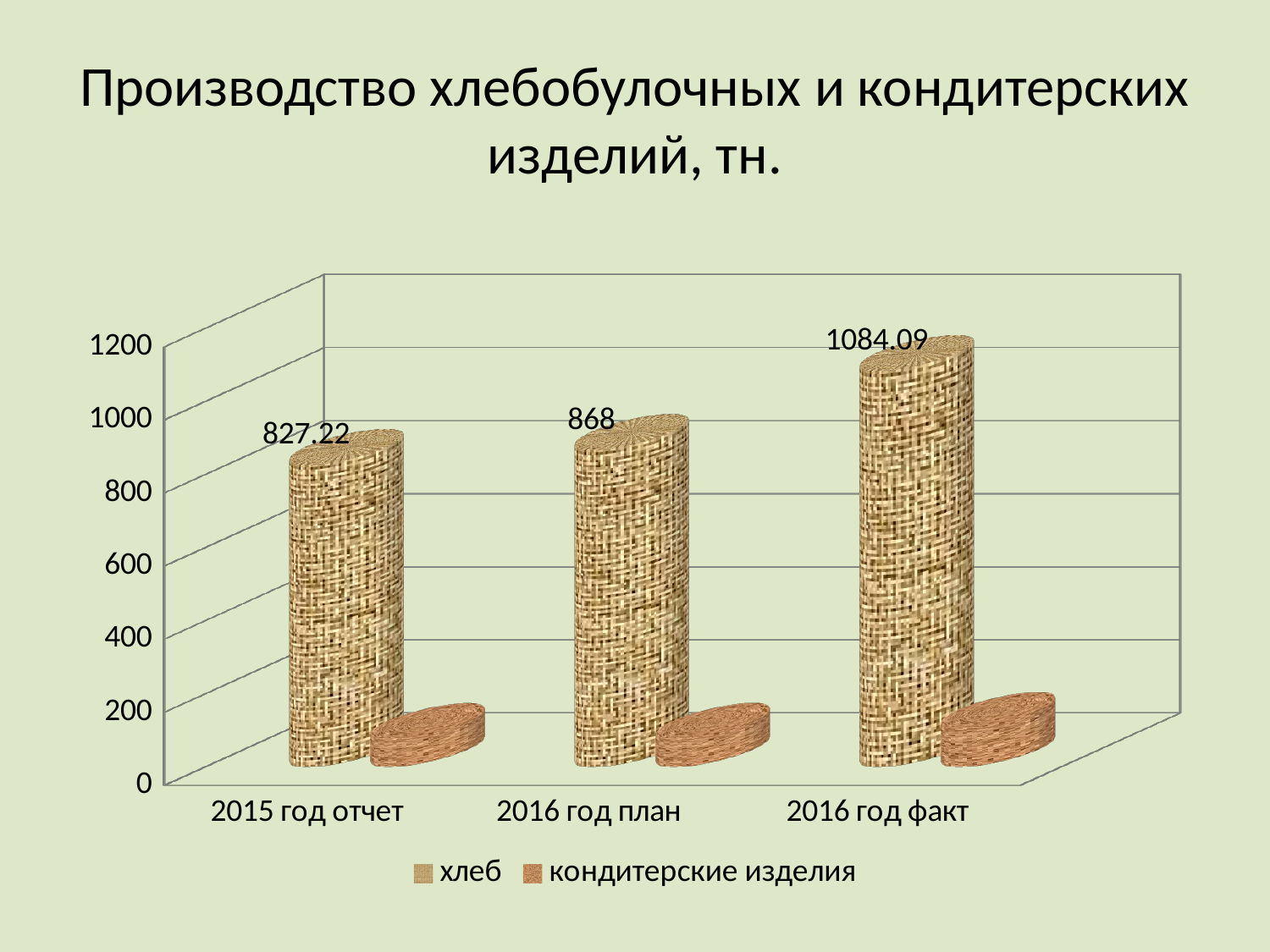
What is the value for хлеб in 2015 год отчет? 827.22 What is the value for хлеб in 2016 год факт? 1084.09 What kind of chart is shown on the slide? bar chart Do the хлеб values rise or fall from 2015 год отчет to 2016 год факт? rise Which category has the highest value for хлеб? 2016 год факт How many categories are shown on the x axis? 3 How many series does the legend list? 2 Which is larger: the хлеб value for 2016 год план or for 2015 год отчет? 2016 год план Is the value for кондитерские изделия in 2016 год факт greater or less than 200? less What is the value for хлеб in 2016 год план? 868 Which category has the lowest value for хлеб? 2015 год отчет What is the difference between the хлеб values for 2016 год факт and 2016 год план? 216.09